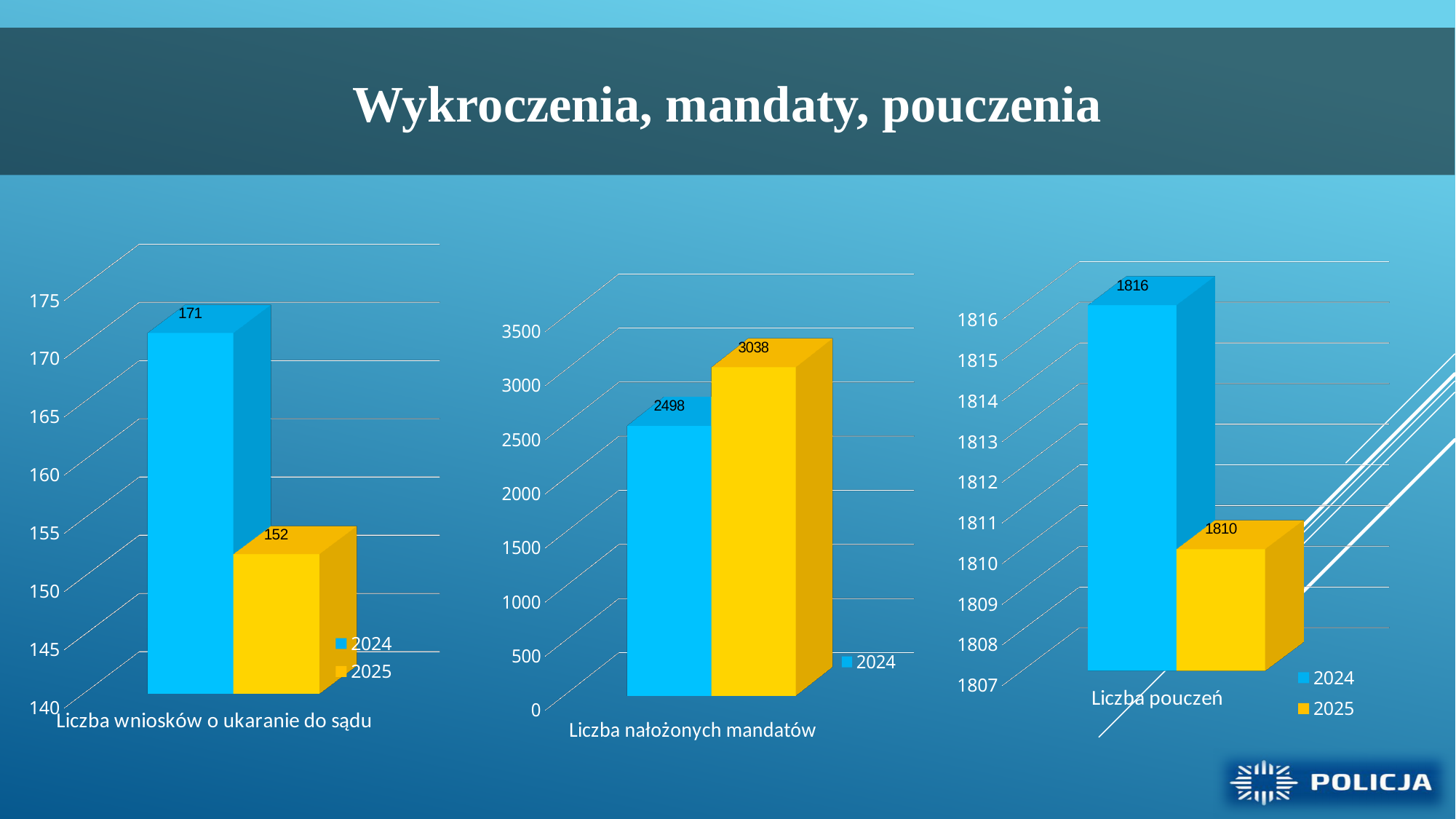
In the middle chart (Liczba nałożonych mandatów), which year has the higher value, 2024 or 2025? 2025 In the right chart (Liczba pouczeń), what is the value for 2024? 1816 In the middle chart (Liczba nałożonych mandatów), what is the value for 2024? 2498 In the left chart (Liczba wniosków o ukaranie do sądu), what is the value for 2025? 152 In the middle chart (Liczba nałożonych mandatów), what is the value for 2025? 3038 In the middle chart (Liczba nałożonych mandatów), what is the difference between the 2025 and 2024 values? 540 In the left chart (Liczba wniosków o ukaranie do sądu), what is the difference between the 2024 and 2025 values? 19 In the right chart (Liczba pouczeń), which year has the lower value? 2025 In the left chart (Liczba wniosków o ukaranie do sądu), what is the value for 2024? 171 How many series does the legend of the right chart (Liczba pouczeń) list? 2 What kind of chart is the left chart (Liczba wniosków o ukaranie do sądu)? bar chart In the right chart (Liczba pouczeń), what is the value for 2025? 1810